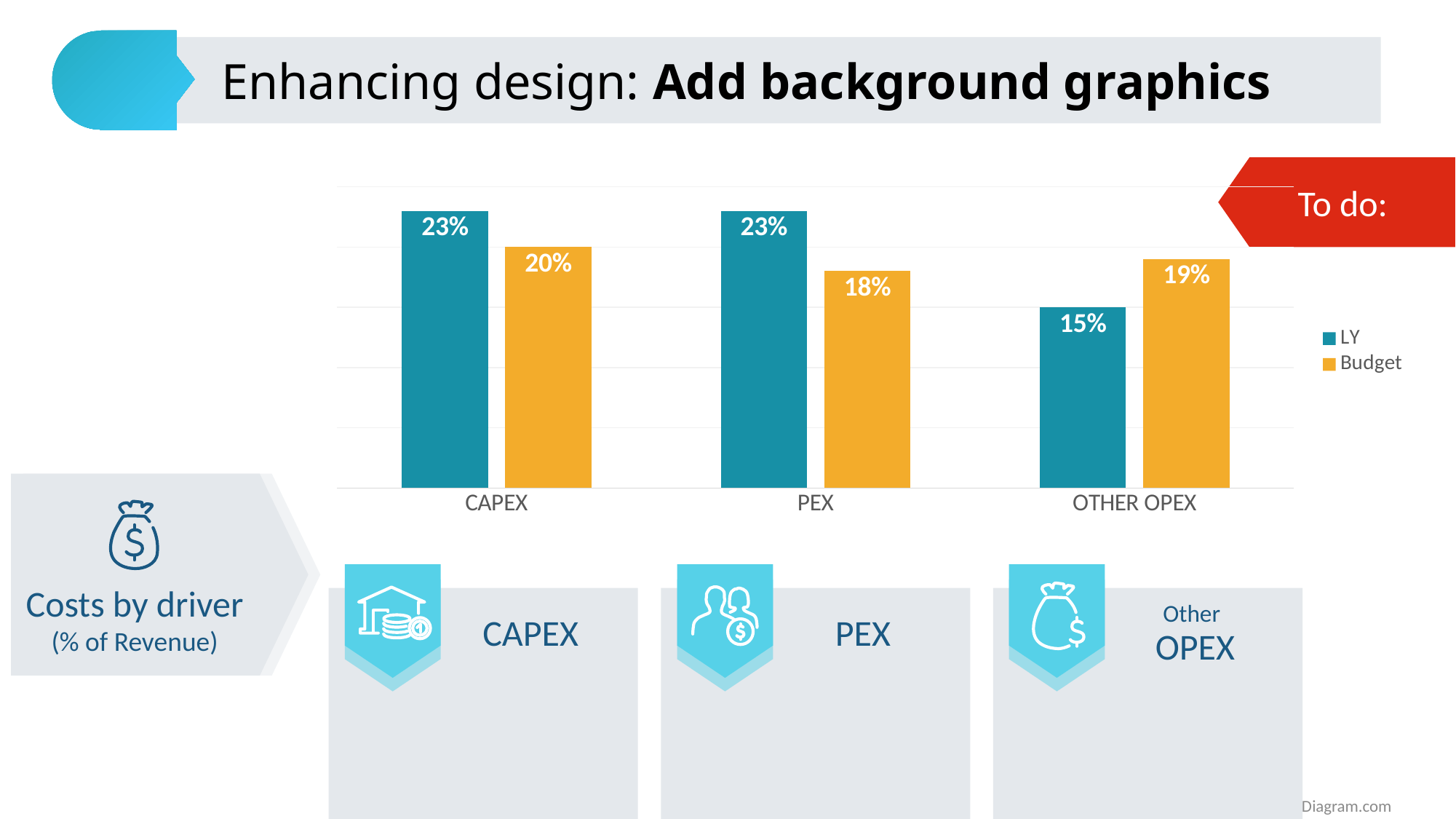
What is the Budget value for PEX? 18% What is the Budget value for OTHER OPEX? 19% What is the LY value for OTHER OPEX? 15% What is the LY value for CAPEX? 23% What is the difference between the LY and Budget values for PEX? 5% What kind of chart is shown? Bar chart Which category has the highest Budget value? CAPEX Which category has the lowest LY value? OTHER OPEX What colour are the Budget bars? Orange How many series does the legend list? 2 How many categories are shown on the x axis? 3 For OTHER OPEX, which is larger, LY or Budget? Budget